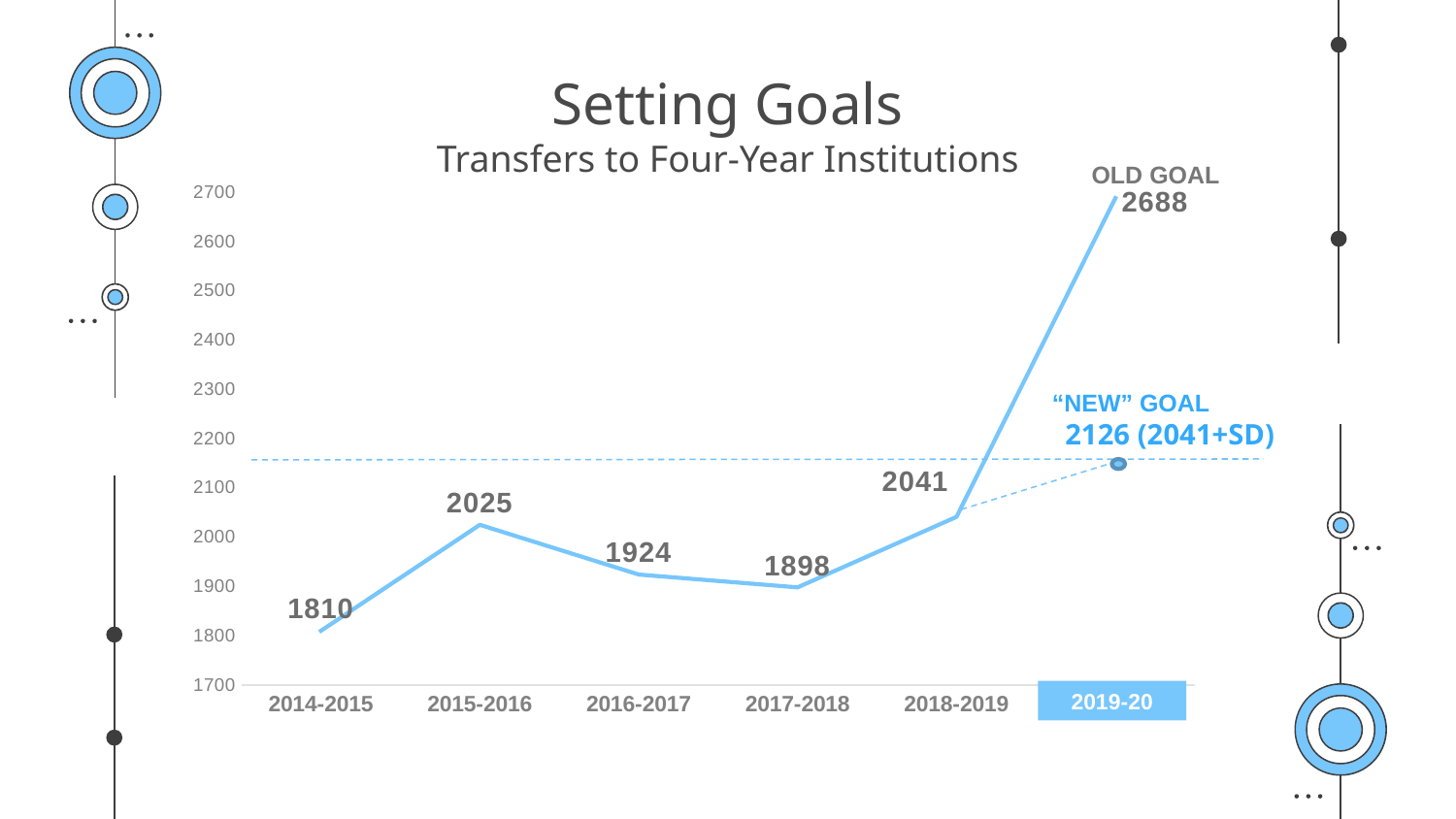
What is the subtitle of the chart? Transfers to Four-Year Institutions What is the "new" goal value shown for 2019-20? 2126 What is the old goal value shown for 2019-20? 2688 What is the difference between the 2015-2016 value and the 2014-2015 value? 215 What is the value for 2018-2019? 2041 What is the value for 2014-2015? 1810 What is the difference between the old goal and the "new" goal for 2019-20? 562 Which year from 2014-2015 to 2018-2019 has the highest value? 2018-2019 Which is larger, the value for 2016-2017 or the value for 2017-2018? 2016-2017 What kind of chart is shown on the slide? Line chart What is the value for 2016-2017? 1924 Which year from 2014-2015 to 2018-2019 has the lowest value? 2014-2015